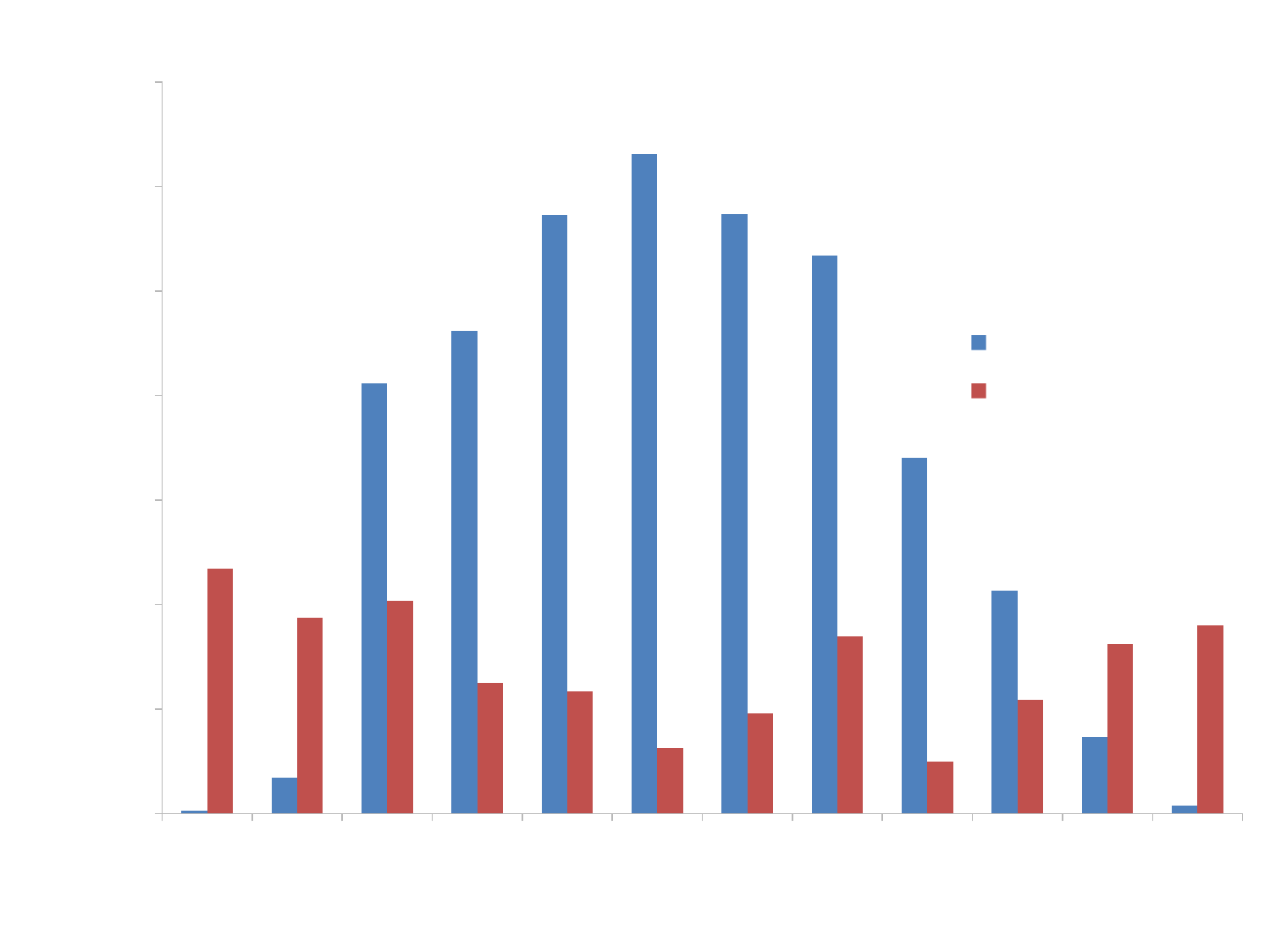
What colours are used for the two series in the chart? blue and red How many series does the legend list? 2 In the leftmost group of bars, which bar is taller, the blue one or the red one? red In the rightmost group of bars, which bar is taller, the blue one or the red one? red Which series, blue or red, contains the tallest bar on the chart? blue Counting from the left, which group contains the tallest blue bar? the 6th group How many groups of bars (categories) are plotted along the x axis? 12 On which side of the plot area is the legend placed? right Counting from the left, which group contains the shortest blue bar? the 1st group Do the blue bars rise and then fall from left to right, or rise steadily across the whole x axis? rise and then fall What kind of chart is shown on the slide? bar chart